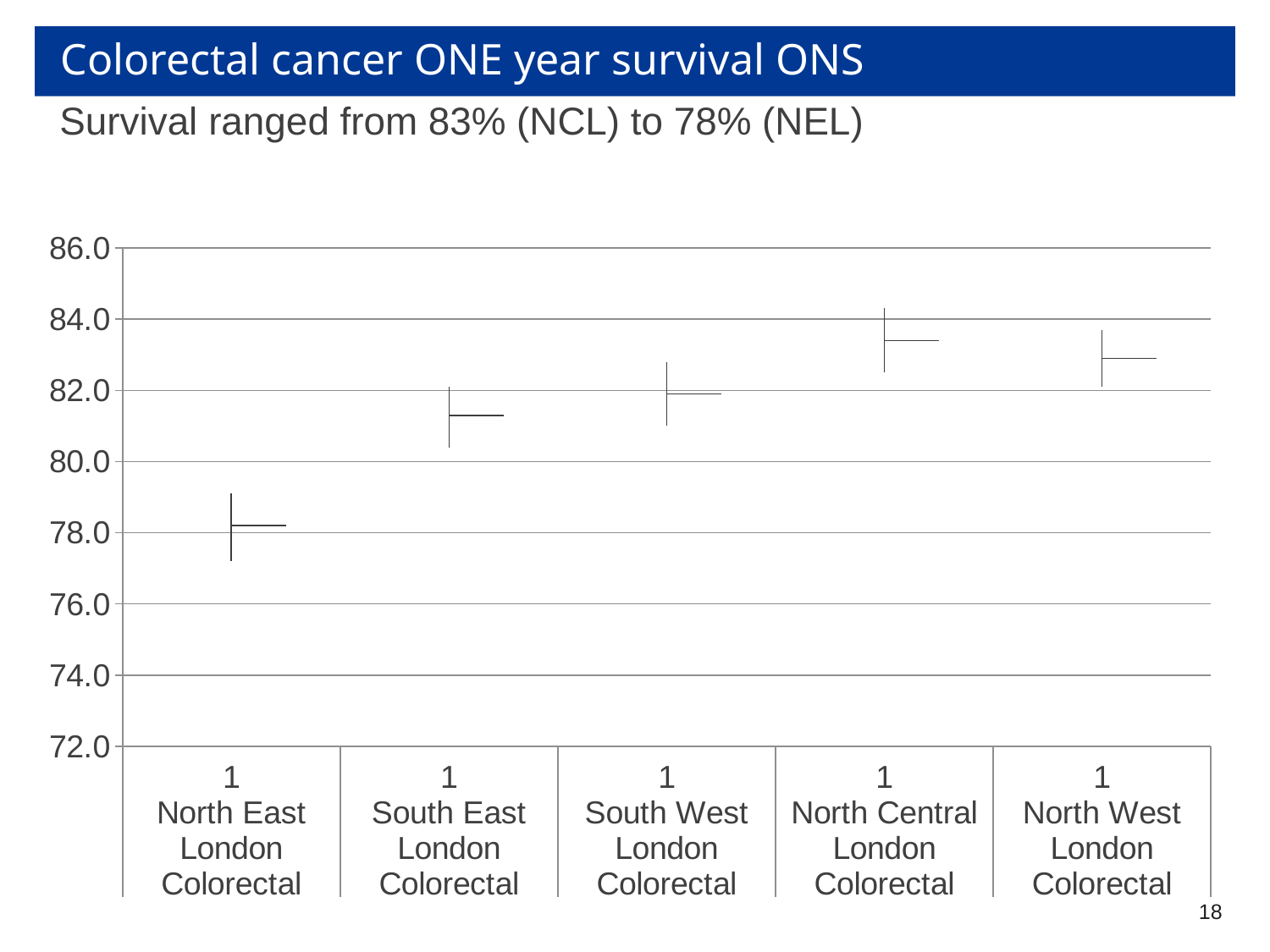
Is the value for South West London Colorectal greater or less than 84.0? less Is the value for North West London Colorectal greater or less than 82.0? greater What is the title of the slide containing the chart? Colorectal cancer ONE year survival ONS Which has the higher survival value, North Central London or South West London? North Central London How many London regions are plotted on the chart? 5 Which region has the lowest one-year colorectal cancer survival on the chart? North East London Which region has the highest one-year colorectal cancer survival on the chart? North Central London What is the highest tick value shown on the vertical axis? 86.0 Is the value for North East London Colorectal greater or less than 80.0? less Which has the higher survival value, North East London or South East London? South East London